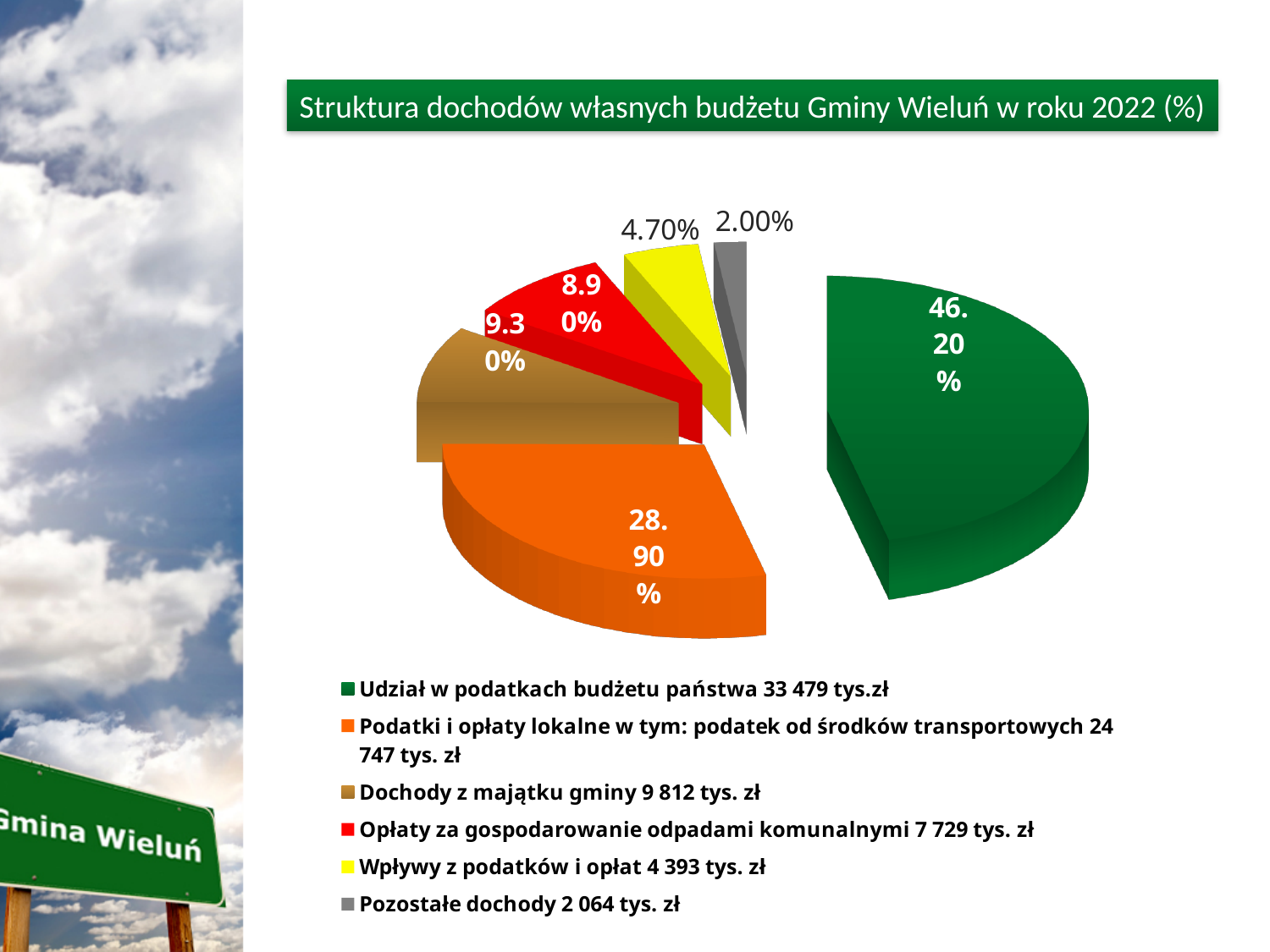
Which slice of the pie chart is the largest? Udział w podatkach budżetu państwa 33 479 tys.zł What percentage is shown for the slice 'Podatki i opłaty lokalne w tym: podatek od środków transportowych 24 747 tys. zł'? 28.90% What is the difference in percentage points between the 'Udział w podatkach budżetu państwa' slice and the 'Podatki i opłaty lokalne' slice? 17.30% What type of chart is shown on the slide? Pie chart What is the title of the chart? Struktura dochodów własnych budżetu Gminy Wieluń w roku 2022 (%) What percentage is shown for the slice 'Opłaty za gospodarowanie odpadami komunalnymi 7 729 tys. zł'? 8.90% Which slice of the pie chart is the smallest? Pozostałe dochody 2 064 tys. zł What percentage is shown for the slice 'Udział w podatkach budżetu państwa 33 479 tys.zł'? 46.20% How many slices does the pie chart have? 6 What percentage is shown for the slice 'Wpływy z podatków i opłat 4 393 tys. zł'? 4.70% What percentage is shown for the slice 'Pozostałe dochody 2 064 tys. zł'? 2.00% What percentage is shown for the slice 'Dochody z majątku gminy 9 812 tys. zł'? 9.30%